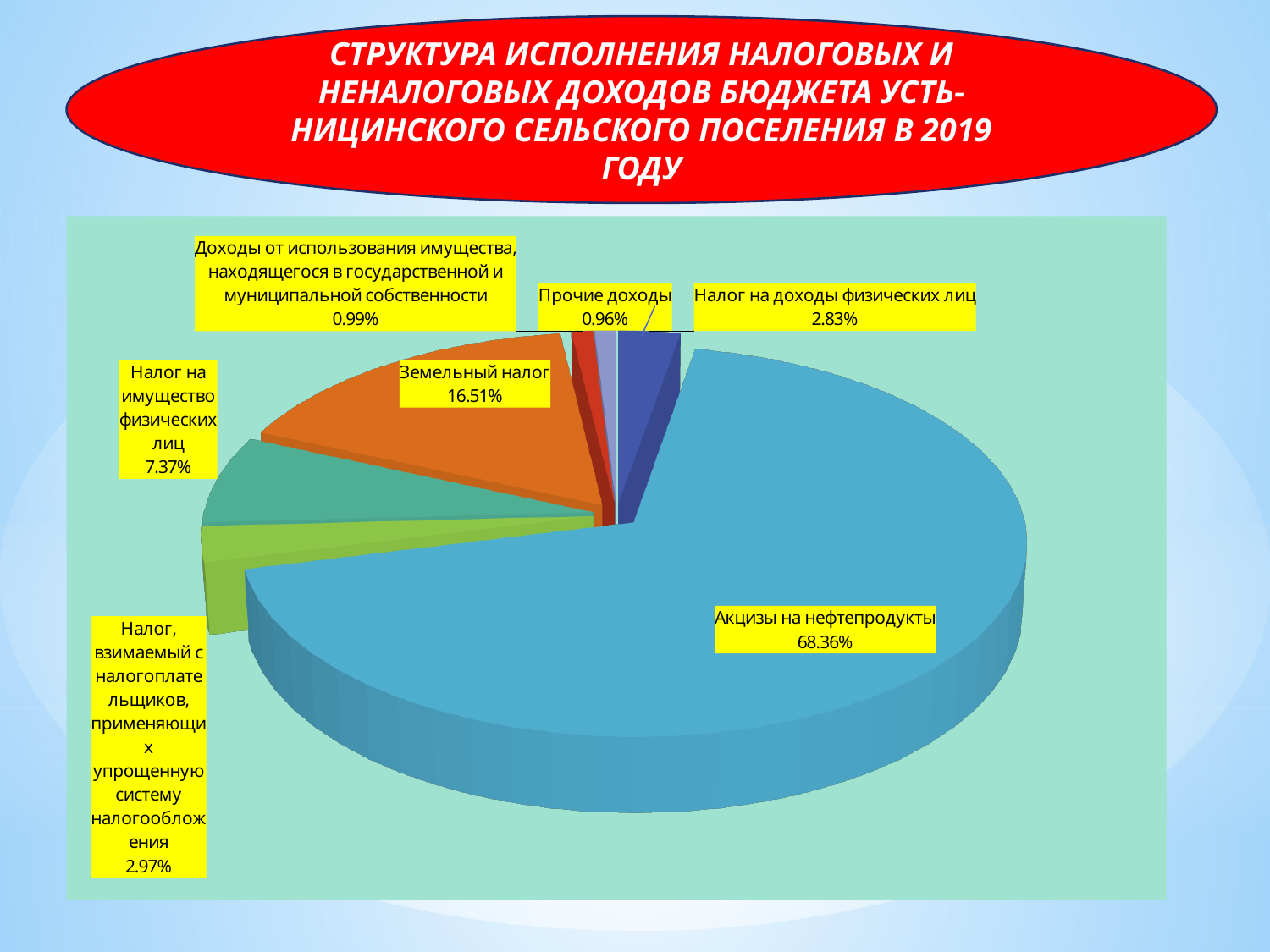
What kind of chart is shown on the slide? Pie chart Which category has the smallest share of the pie? Прочие доходы What is the value shown for "Налог на имущество физических лиц"? 7.37% What share does "Акцизы на нефтепродукты" have in the pie chart? 68.36% Which is larger: the share for "Земельный налог" or for "Налог на имущество физических лиц"? Земельный налог What is the difference between the shares of "Налог, взимаемый с налогоплательщиков, применяющих упрощенную систему налогообложения" and "Налог на доходы физических лиц"? 0.14% What is the value shown for "Налог на доходы физических лиц"? 2.83% What is the value shown for "Земельный налог"? 16.51% What is the difference between the shares of "Акцизы на нефтепродукты" and "Земельный налог"? 51.85% Which category has the largest share of the pie? Акцизы на нефтепродукты How many slices does the pie chart have? 7 What is the value shown for "Прочие доходы"? 0.96%